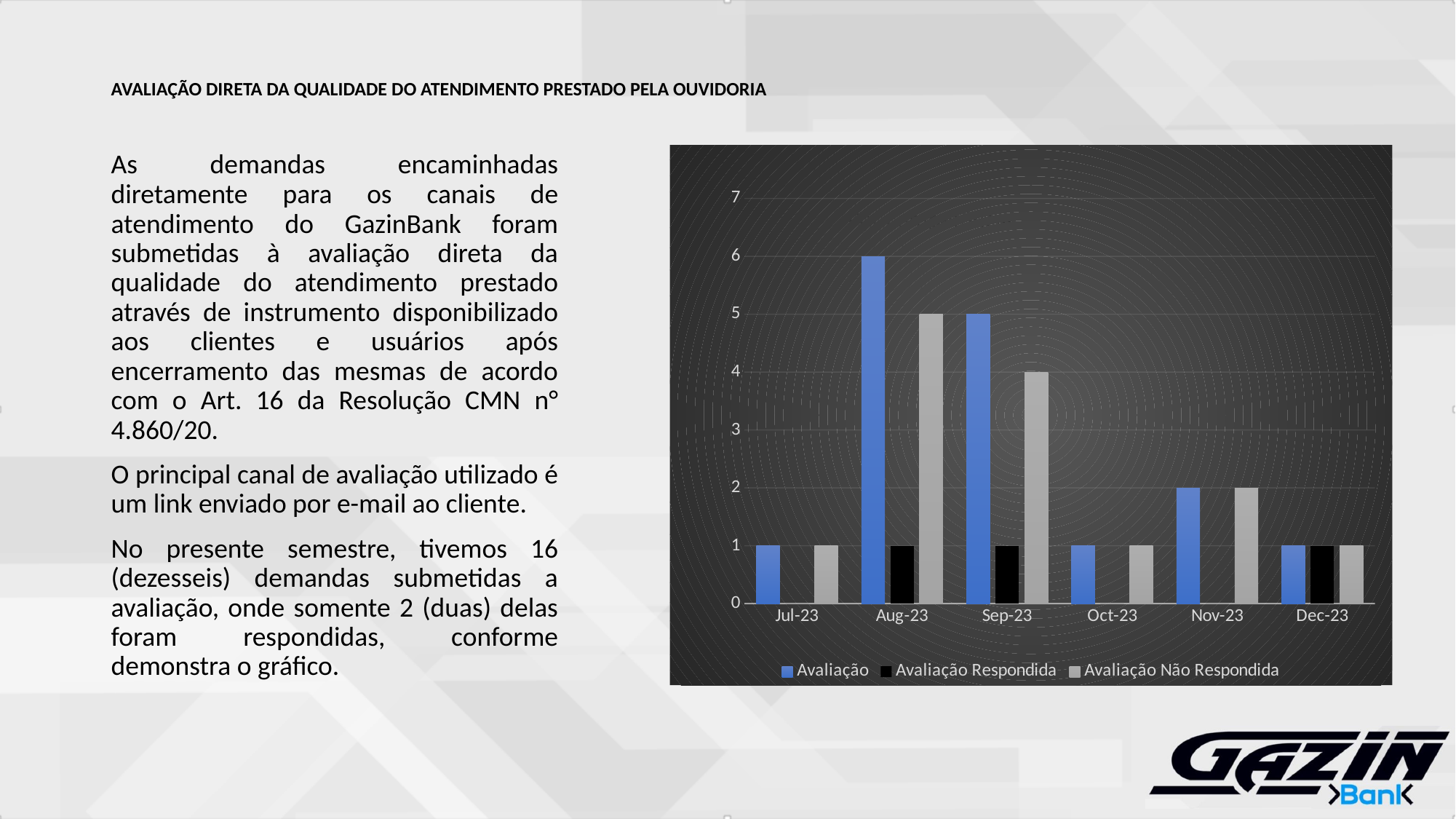
What kind of chart is shown on the slide? bar chart Which is larger, the Avaliação value for Sep-23 or for Oct-23? Sep-23 What is the value of Avaliação for Nov-23? 2 What is the value of Avaliação Respondida for Dec-23? 1 In which month is the Avaliação value highest? Aug-23 What is the difference between the Avaliação value for Aug-23 and the Avaliação Não Respondida value for Aug-23? 1 Which series in the legend is shown in black? Avaliação Respondida How many months are shown on the x axis of the chart? 6 How many series does the chart legend list? 3 Is the Avaliação value for Aug-23 greater or less than 5? greater What is the value of Avaliação Não Respondida for Sep-23? 4 What is the value of Avaliação for Aug-23? 6